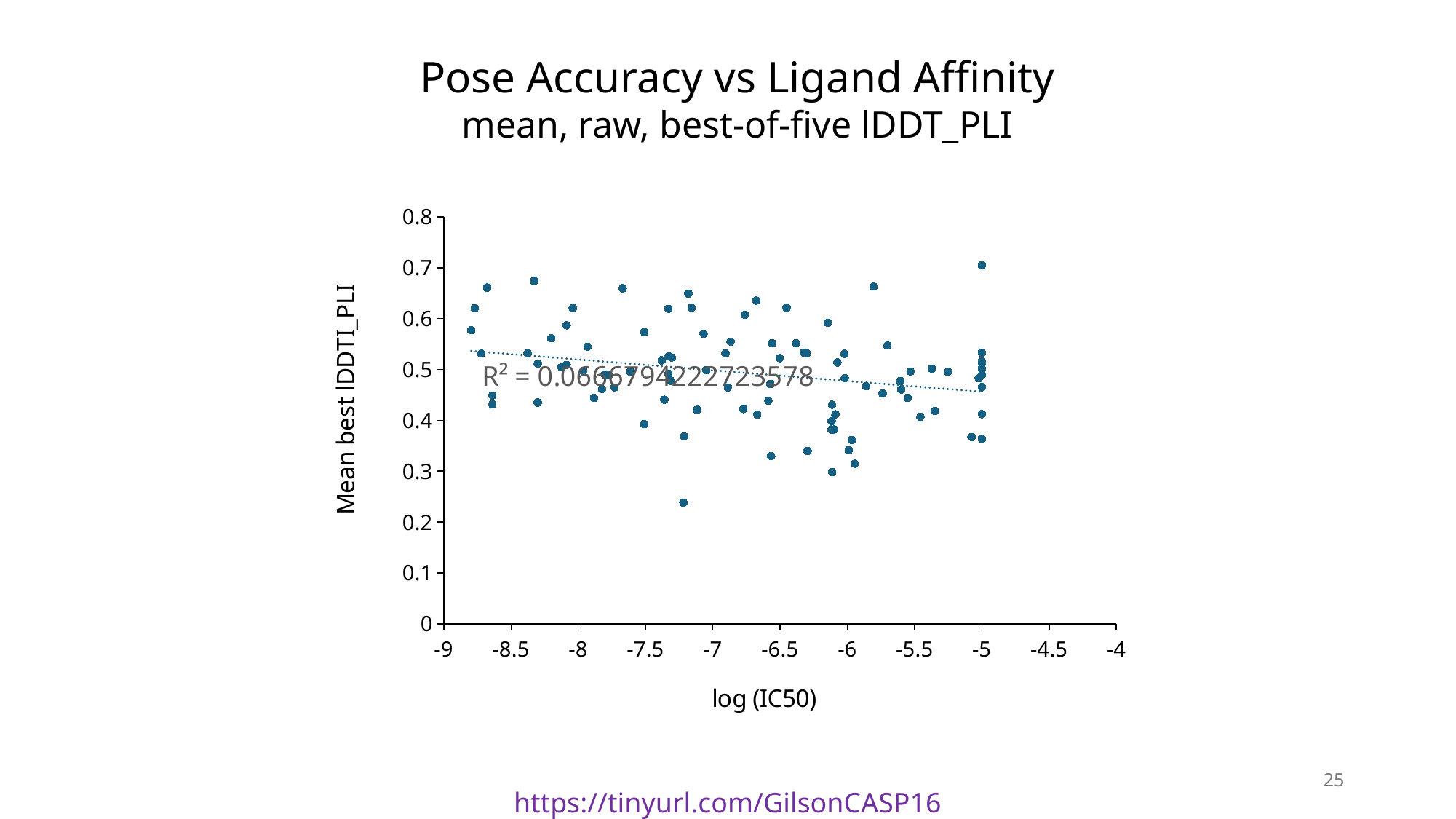
What is the maximum value shown on the x axis? -4 What is the title of the chart? Pose Accuracy vs Ligand Affinity Is the lowest plotted point located at an x value greater or less than -6? less What R² value is printed on the chart? R² = 0.0666794222723578 Is the lowest plotted point on the chart greater or less than 0.3 on the y axis? less What is the maximum value shown on the y axis? 0.8 What is the minimum value shown on the x axis? -9 Does the dotted trendline rise or fall as log (IC50) increases along the x axis? fall What kind of chart is shown on the slide? scatter plot What is the label of the x axis? log (IC50) Is the highest plotted point on the chart greater or less than 0.6 on the y axis? greater